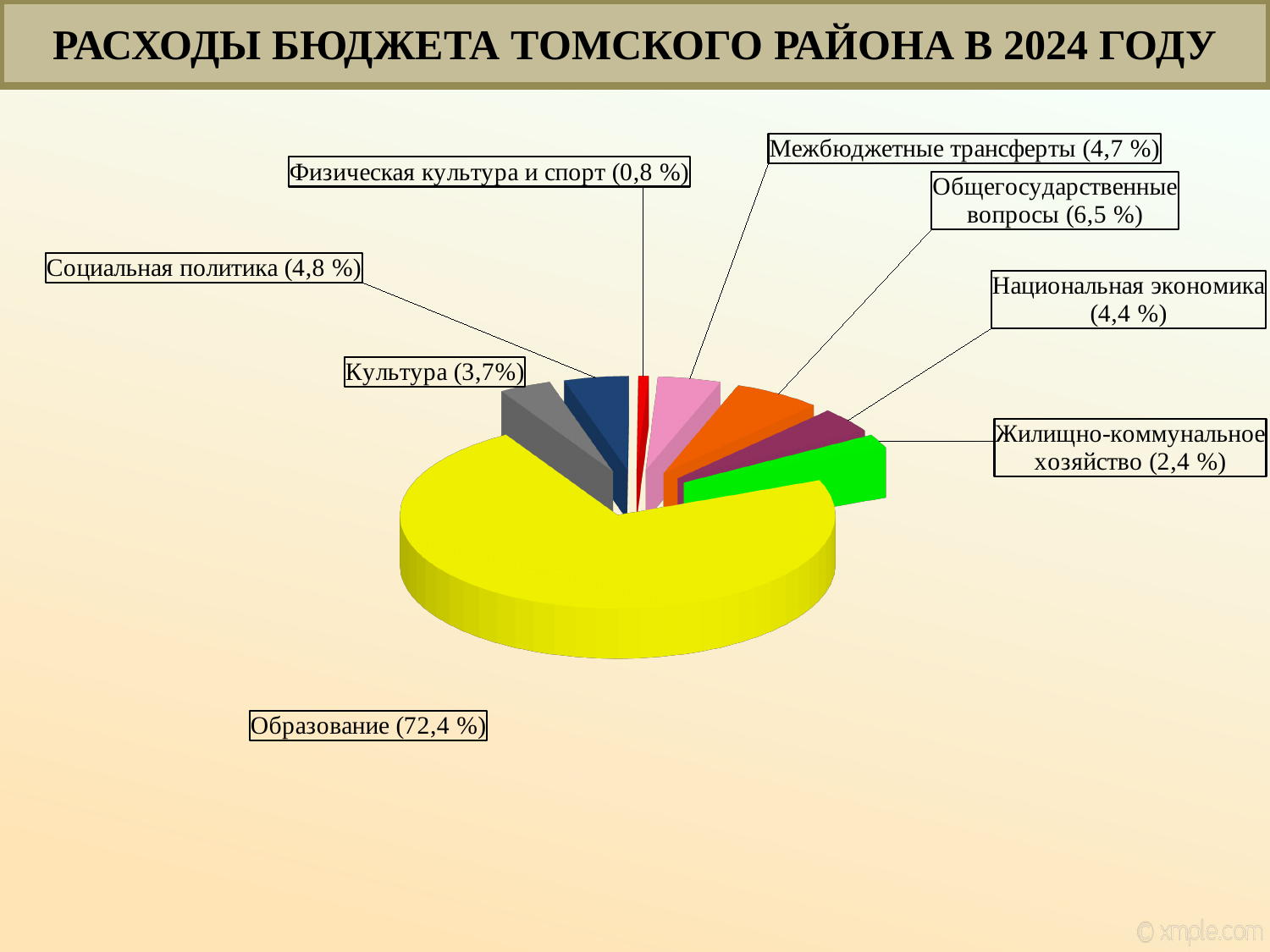
What share is shown for Жилищно-коммунальное хозяйство? 2,4 % What is the title of the slide? РАСХОДЫ БЮДЖЕТА ТОМСКОГО РАЙОНА В 2024 ГОДУ What colour is the Образование slice? Yellow What type of chart is shown on the slide? Pie chart What is the difference in percentage points between Социальная политика and Жилищно-коммунальное хозяйство? 2,4 Which has a larger share: Общегосударственные вопросы or Национальная экономика? Общегосударственные вопросы What share is shown for Общегосударственные вопросы? 6,5 % How many categories (slices) does the pie chart have? 8 What share of the budget expenses goes to Образование? 72,4 % What share is shown for Культура? 3,7% Which category has the largest share of the pie? Образование Which category has the smallest share of the pie? Физическая культура и спорт